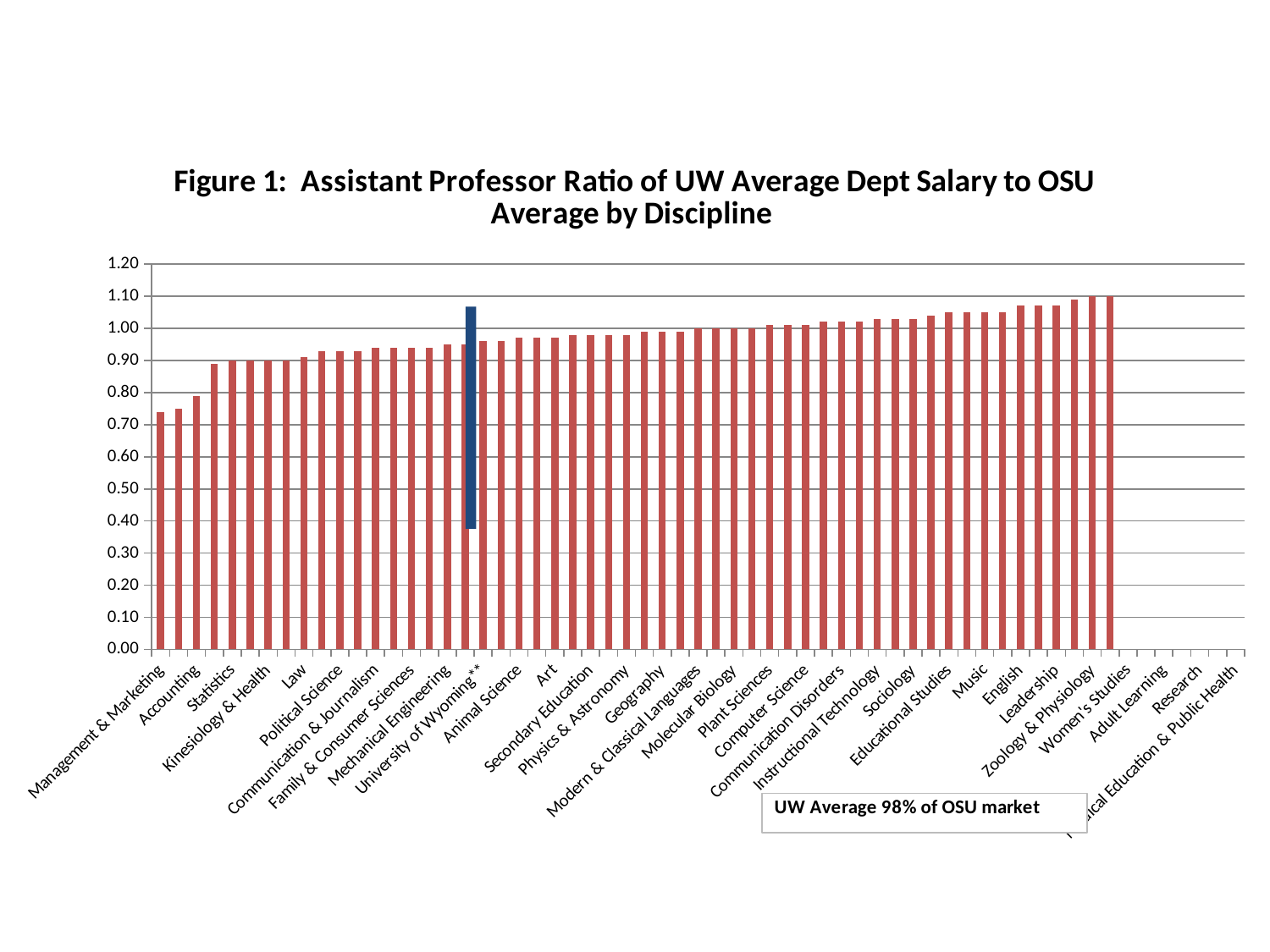
Which is larger, the leftmost bar or the rightmost bar? The rightmost bar Do the bar values generally rise or fall from left to right along the x axis? Rise Is the value for Management & Marketing greater or less than 0.80? less What is the highest tick value shown on the y axis? 1.20 Which category has the lowest bar on the chart? Management & Marketing Is the tallest bar on the chart greater or less than 1.00? greater What is the title of the chart? Figure 1: Assistant Professor Ratio of UW Average Dept Salary to OSU Average by Discipline Is the value for Management & Marketing greater or less than 0.70? greater What type of chart is shown on the slide? Bar chart Which category is highlighted with a blue bar instead of a red one? University of Wyoming**